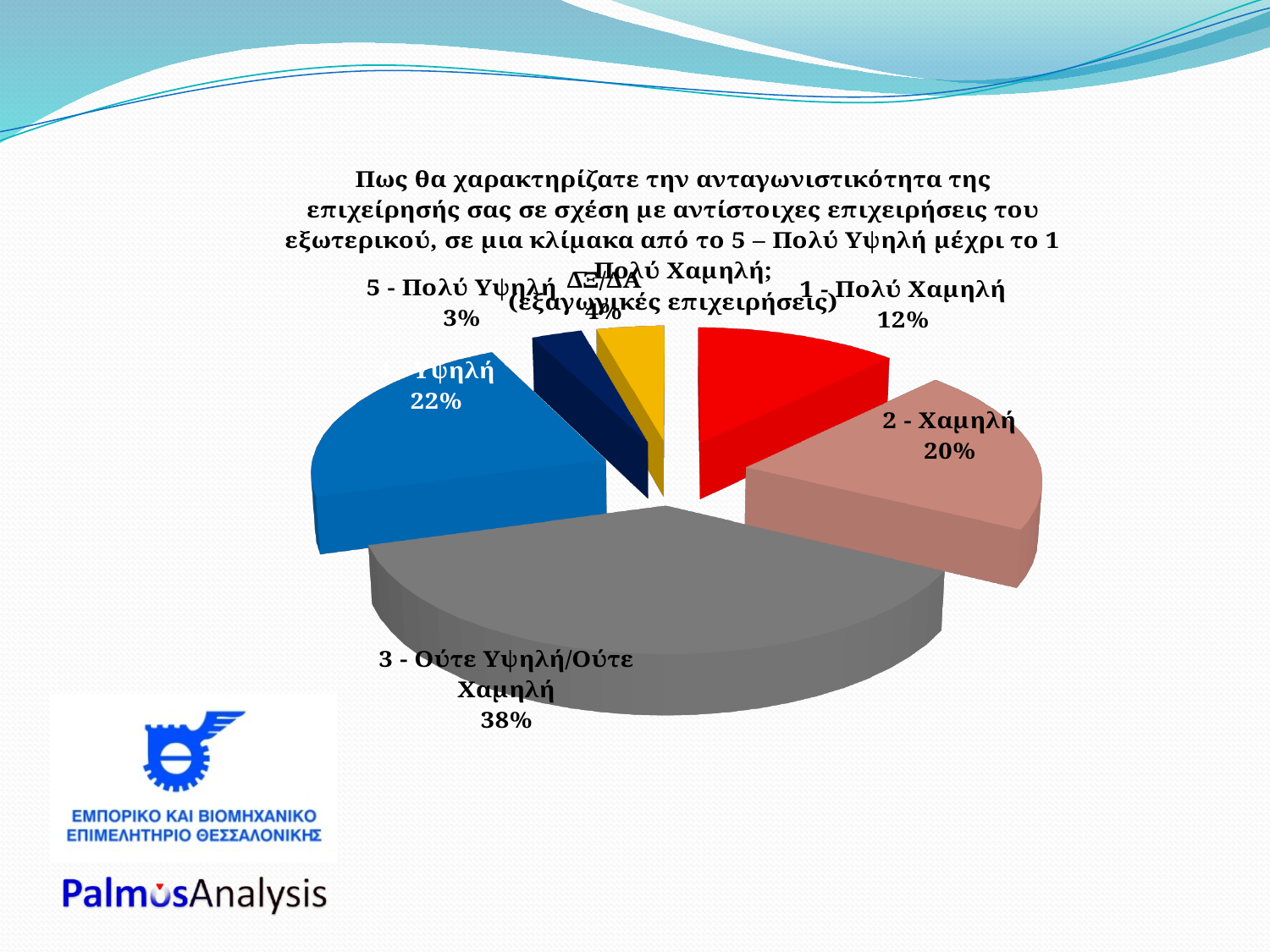
What is the value shown for "4 - Υψηλή"? 22% What share of the pie does the slice "3 - Ούτε Υψηλή/Ούτε Χαμηλή" represent? 38% What kind of chart is shown on the slide? Pie chart Which is larger, the slice for "2 - Χαμηλή" or the slice for "4 - Υψηλή"? 4 - Υψηλή Which category has the largest slice of the pie? 3 - Ούτε Υψηλή/Ούτε Χαμηλή What is the value shown for "2 - Χαμηλή"? 20% Which category has the smallest slice of the pie? 5 - Πολύ Υψηλή What is the value shown for "5 - Πολύ Υψηλή"? 3% What is the value shown for "1 - Πολύ Χαμηλή"? 12% What colour is the slice for "3 - Ούτε Υψηλή/Ούτε Χαμηλή"? Grey How many slices does the pie chart have? 6 What is the difference in percentage points between "3 - Ούτε Υψηλή/Ούτε Χαμηλή" and "4 - Υψηλή"? 16 percentage points